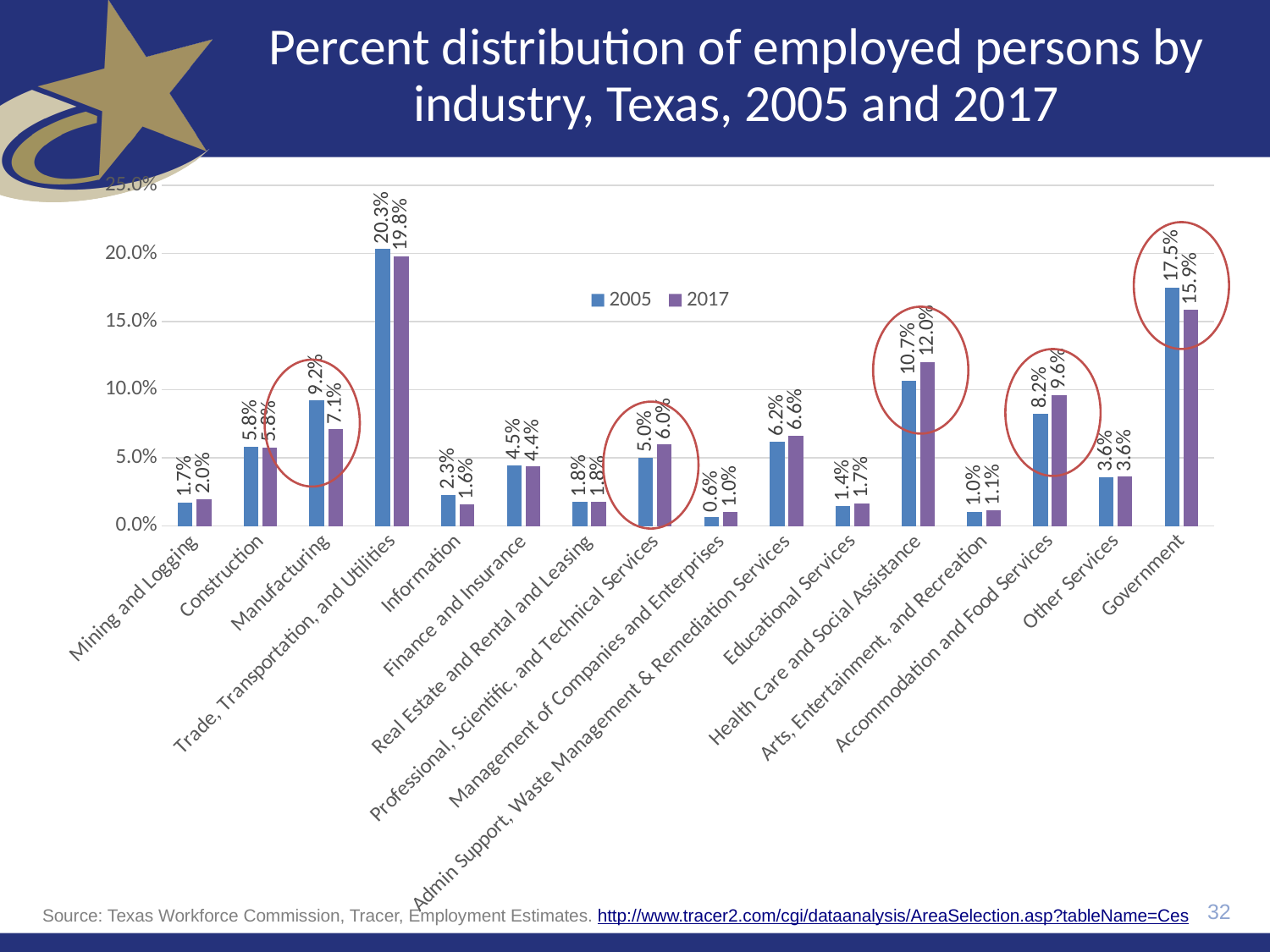
What is the difference between the 2005 and 2017 values for Accommodation and Food Services? 1.4% What was the 2017 value for Government? 15.9% What was the 2017 value for Health Care and Social Assistance? 12.0% Which industry had the lowest share of employed persons in 2005? Management of Companies and Enterprises Which is larger for Government: the 2005 value or the 2017 value? 2005 How many series does the legend list? 2 What is the difference between the 2005 and 2017 values for Manufacturing? 2.1% Is the 2017 value for Trade, Transportation, and Utilities greater or less than 15.0%? greater How many industries are shown on the x axis? 16 What kind of chart is shown on the slide? Bar chart What was the 2005 value for Manufacturing? 9.2% Which industry had the highest share of employed persons in 2005? Trade, Transportation, and Utilities